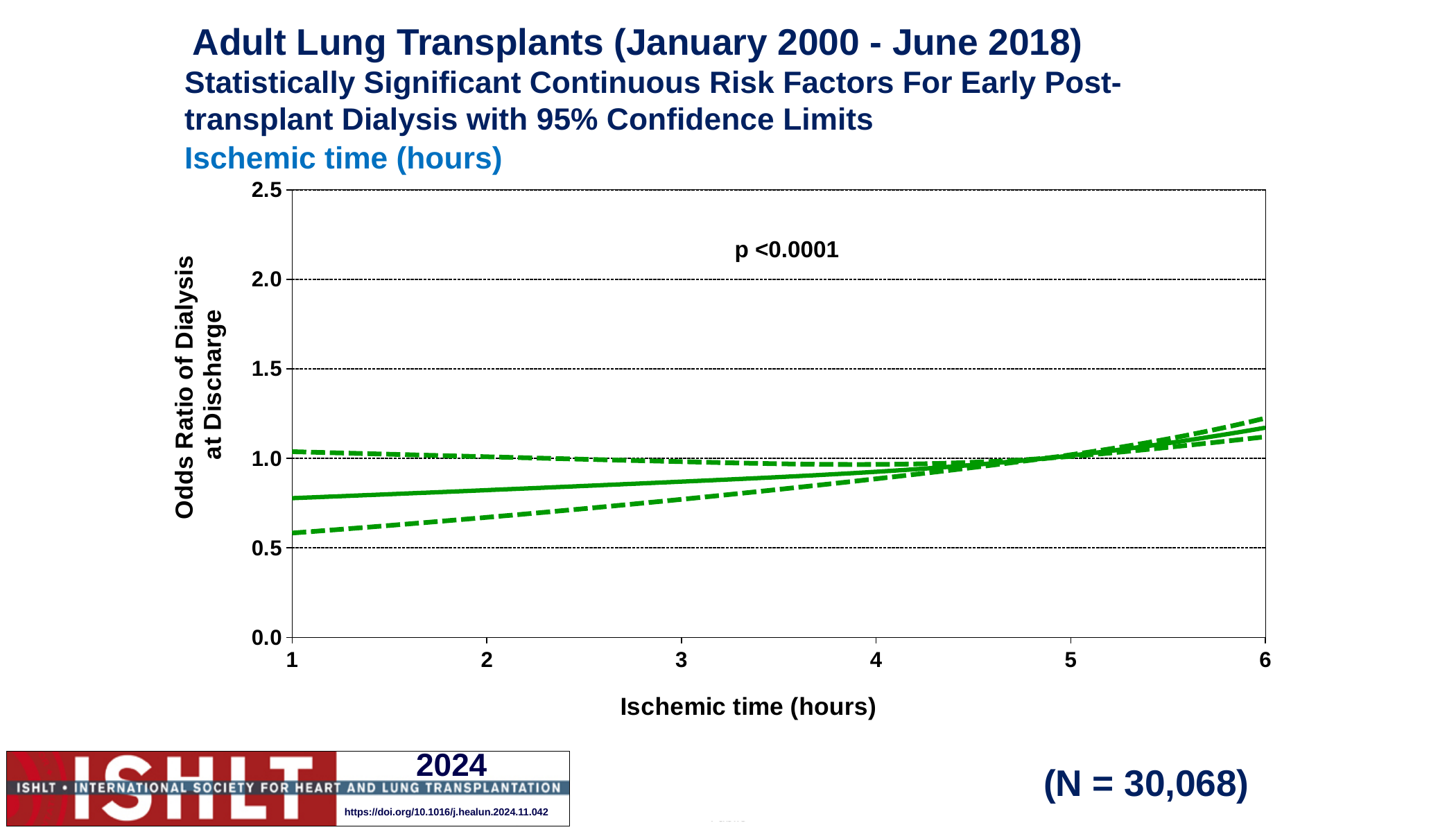
What is the label of the x axis? Ischemic time (hours) How many labelled tick values are shown on the x axis? 6 Is the lower dashed confidence limit at 1 hour of ischemic time greater or less than 0.5? greater Is the upper dashed confidence limit at 6 hours of ischemic time greater or less than 1.0? greater Is the odds ratio on the solid line at 6 hours of ischemic time greater or less than 1.0? greater How many lines are plotted on the chart? 3 Does the solid odds ratio line rise or fall as ischemic time increases from 1 to 6 hours? rises What p-value is printed on the chart? p <0.0001 What kind of chart is shown on the slide? line chart